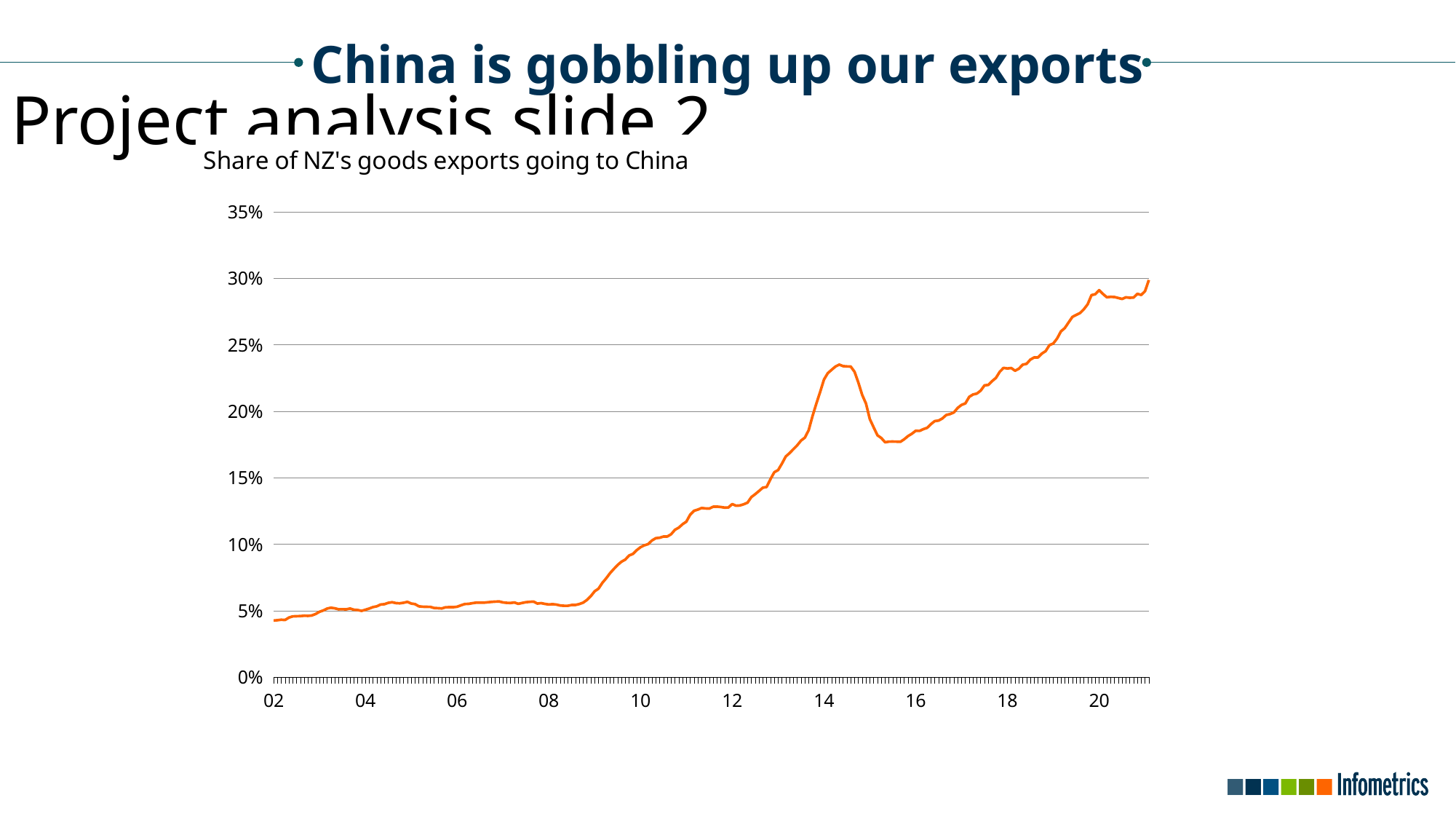
Overall, does the share of NZ's goods exports going to China rise or fall from 2002 to 2021? rise Is the value for 2008 greater or less than 10%? less Is the value for 2012 greater or less than 10%? greater What is the highest value shown on the y axis? 35% Which is larger, the value for 2008 or the value for 2012? 2012 What kind of chart is shown on the slide? line chart Is the value for 2004 greater or less than 10%? less Which is larger, the value for 2014 or the value for 2016? 2014 What is the title of the chart? Share of NZ's goods exports going to China How many lines are plotted on the chart? 1